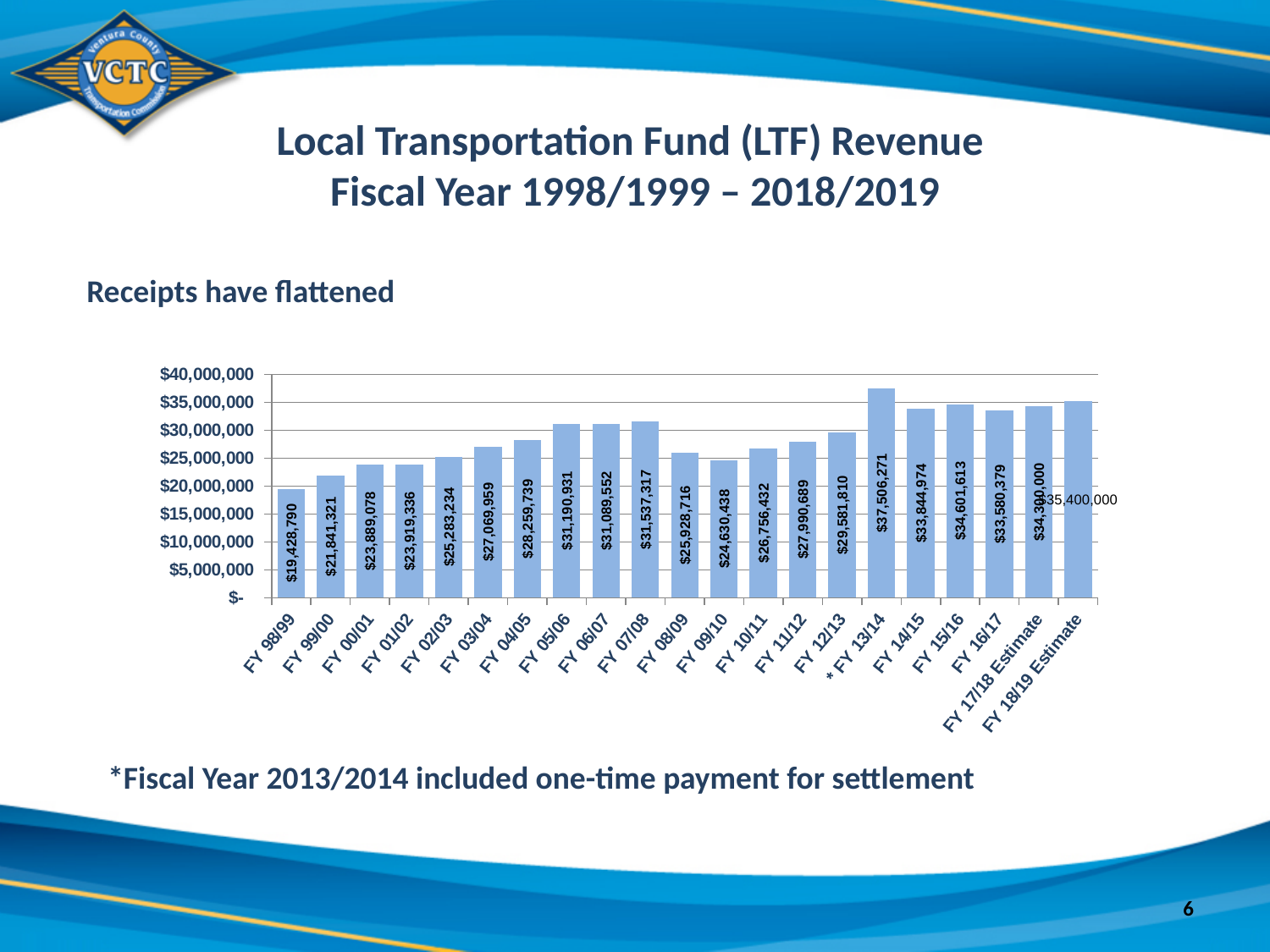
What is the difference between the LTF revenue for FY 07/08 and FY 08/09? $5,608,601 Which is larger, the LTF revenue for FY 11/12 or FY 12/13? FY 12/13 What is the difference between the LTF revenue for FY 13/14 and FY 14/15? $3,661,297 Is the LTF revenue for FY 13/14 greater or less than $35,000,000? greater What kind of chart is shown on the slide? Bar chart Which fiscal year has the highest LTF revenue? FY 13/14 What is the LTF revenue for FY 07/08? $31,537,317 How many fiscal years are shown on the chart? 21 Which fiscal year has the lowest LTF revenue? FY 98/99 What is the LTF revenue for FY 18/19 Estimate? $35,400,000 What is the LTF revenue for FY 98/99? $19,428,790 Does the LTF revenue rise or fall from FY 98/99 to FY 07/08? Rise